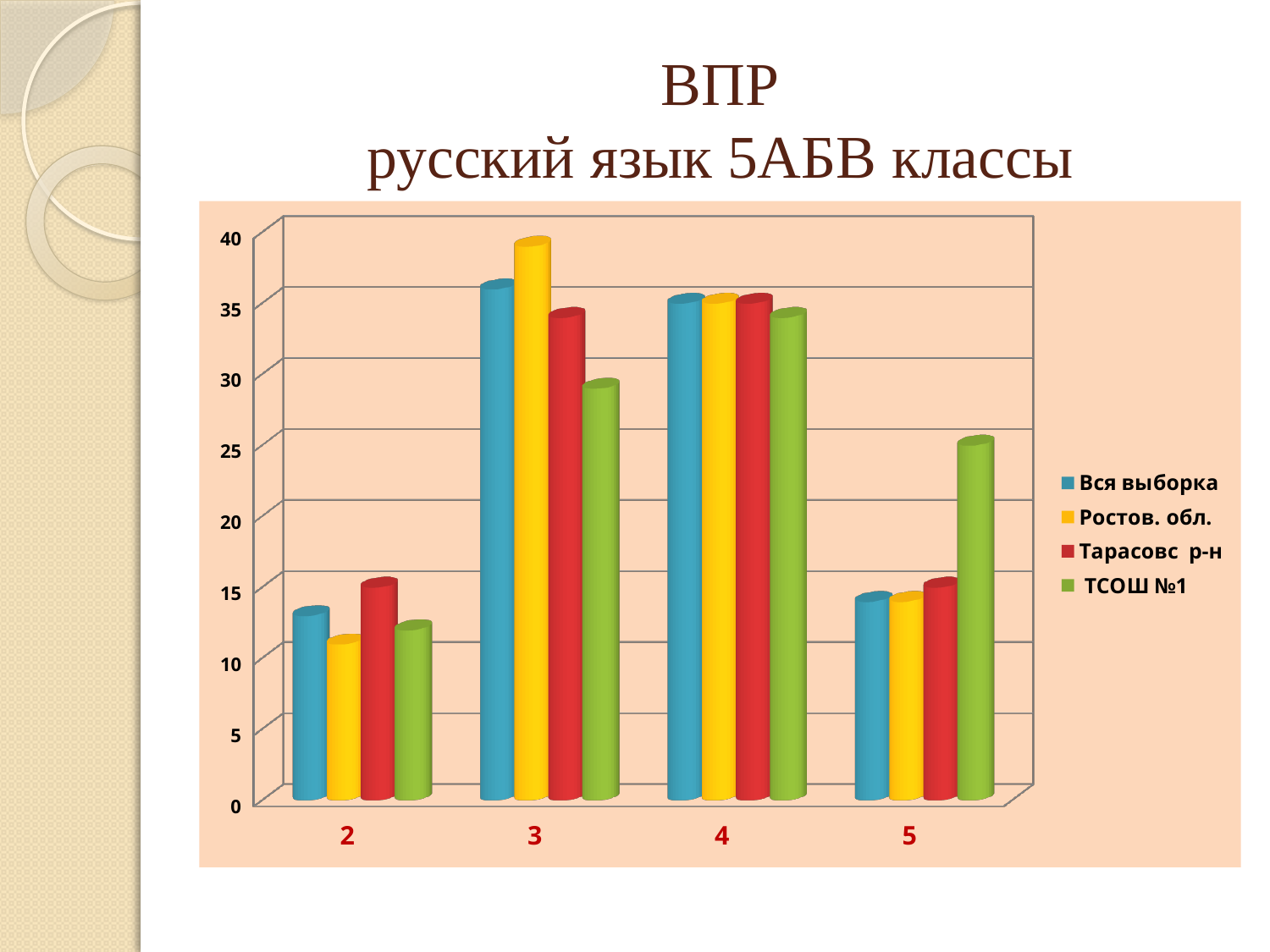
Which series has the lowest value for category 3? ТСОШ №1 What colour represents the series ТСОШ №1 in the chart? green Is the value for ТСОШ №1 in category 5 greater or less than 20? greater Is the value for Вся выборка in category 3 greater or less than 35? greater Which series has the highest value for category 5? ТСОШ №1 How many categories are shown on the x axis of the chart? 4 Which series has the highest value for category 3? Ростов. обл. Which is larger: the value for Тарасовс р-н in category 2 or for Ростов. обл. in category 2? Тарасовс р-н What kind of chart is shown on the slide? bar chart Is the value for Ростов. обл. in category 2 greater or less than 15? less Which is larger: the value for ТСОШ №1 in category 3 or in category 4? category 4 How many series does the chart's legend list? 4